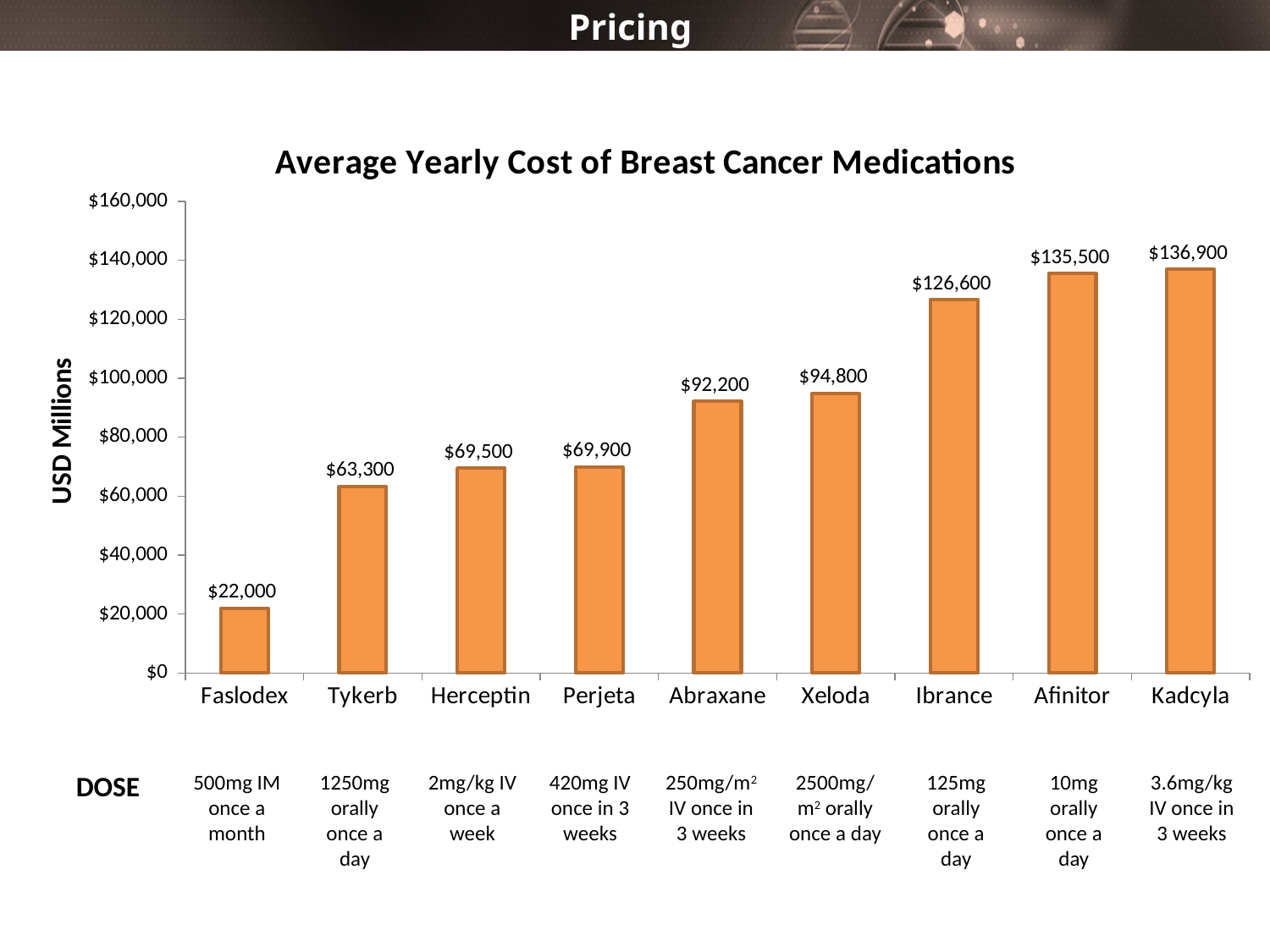
Do the values rise or fall from left to right across the medications? Rise Is the value for Abraxane greater or less than $100,000? less What type of chart is used to show the average yearly cost of breast cancer medications? Bar chart What is the difference between the yearly cost of Xeloda and Abraxane? $2,600 What is the average yearly cost shown for Herceptin? $69,500 What is the average yearly cost shown for Ibrance? $126,600 How many medications are shown in the chart? 9 Which has a higher average yearly cost, Tykerb or Afinitor? Afinitor Which medication has the lowest average yearly cost? Faslodex Which medication has the highest average yearly cost? Kadcyla What is the label on the vertical axis of the chart? USD Millions What is the difference between the yearly cost of Kadcyla and Faslodex? $114,900